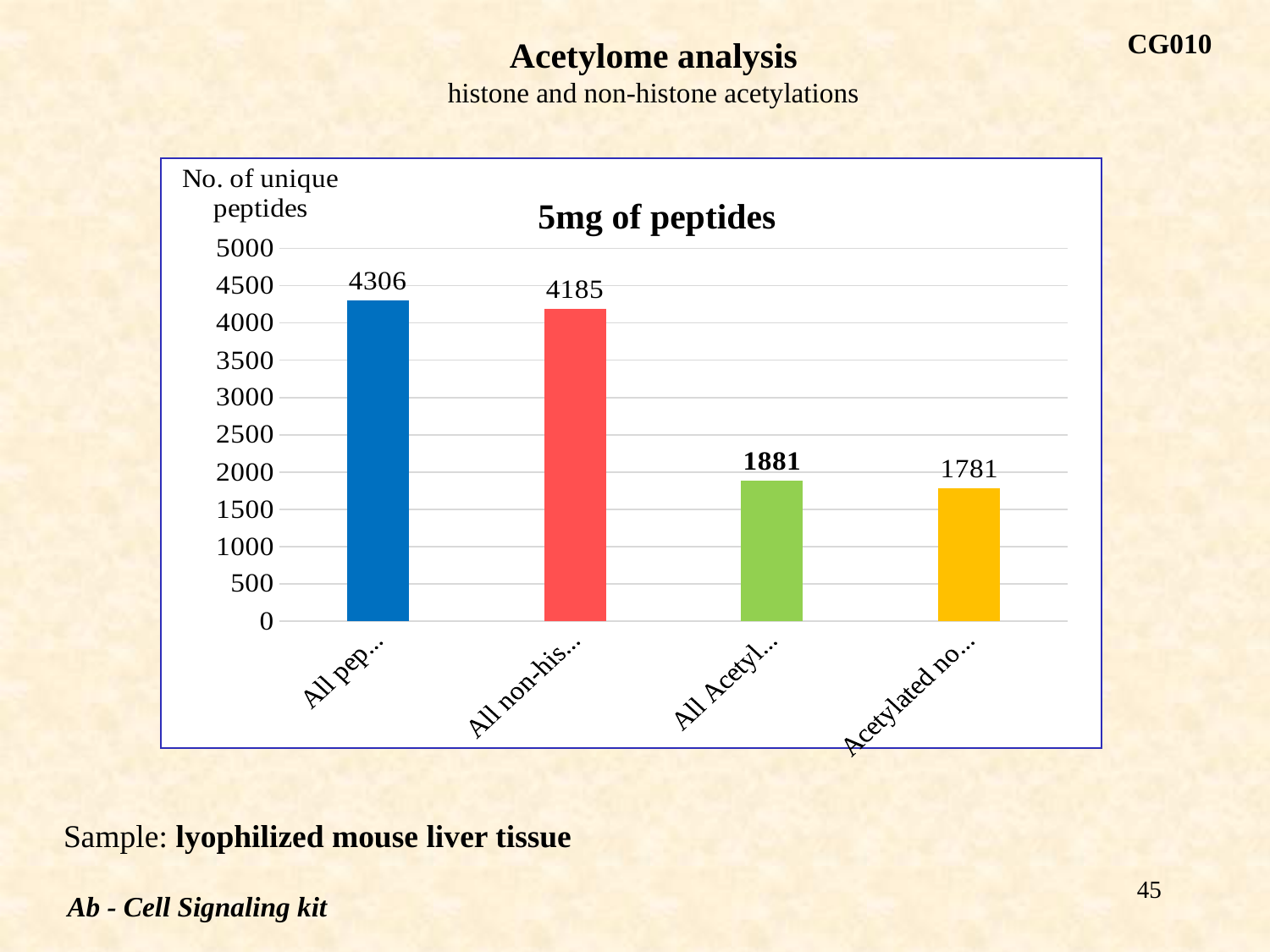
Which bar has the highest value? All pep... (the blue bar) What type of chart is shown on the slide? Bar chart What is the value of the yellow bar, labelled "Acetylated no..."? 1781 What is the difference between the blue bar (4306) and the red bar (4185)? 121 What is the title of the chart? 5mg of peptides Which is larger, the value of the red bar or the value of the green bar? The red bar (4185) What is the difference between the green bar (1881) and the yellow bar (1781)? 100 Which bar has the lowest value? Acetylated no... (the yellow bar) How many bars are plotted in the chart? 4 What is the value of the first (blue) bar, labelled "All pep..."? 4306 What is the value of the red bar, labelled "All non-his..."? 4185 What is the value of the green bar, labelled "All Acetyl..."? 1881